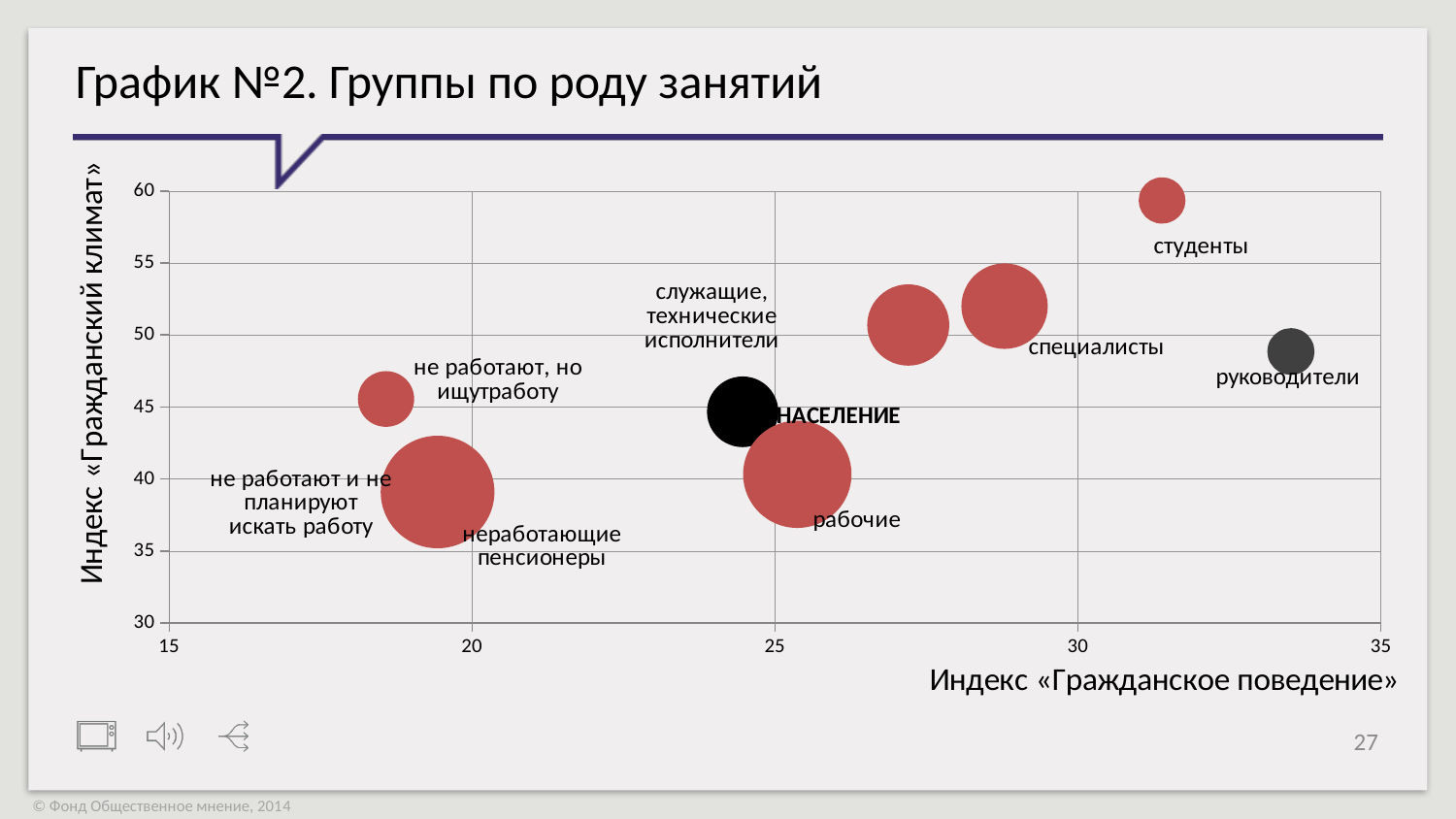
Which group has the highest value on the «Гражданское поведение» index (horizontal axis)? руководители What kind of chart is shown on the slide? bubble chart Is the «Гражданский климат» value for специалисты greater or less than 50? greater Is the «Гражданское поведение» value for НАСЕЛЕНИЕ greater or less than 25? less Is the «Гражданский климат» value for студенты greater or less than 55? greater Which has a higher «Гражданское поведение» value: студенты or НАСЕЛЕНИЕ? студенты Which group has the highest value on the «Гражданский климат» index (vertical axis)? студенты Which has a higher «Гражданский климат» value: специалисты or рабочие? специалисты What is the label of the vertical axis? Индекс «Гражданский климат» What is the title of the chart? График №2. Группы по роду занятий